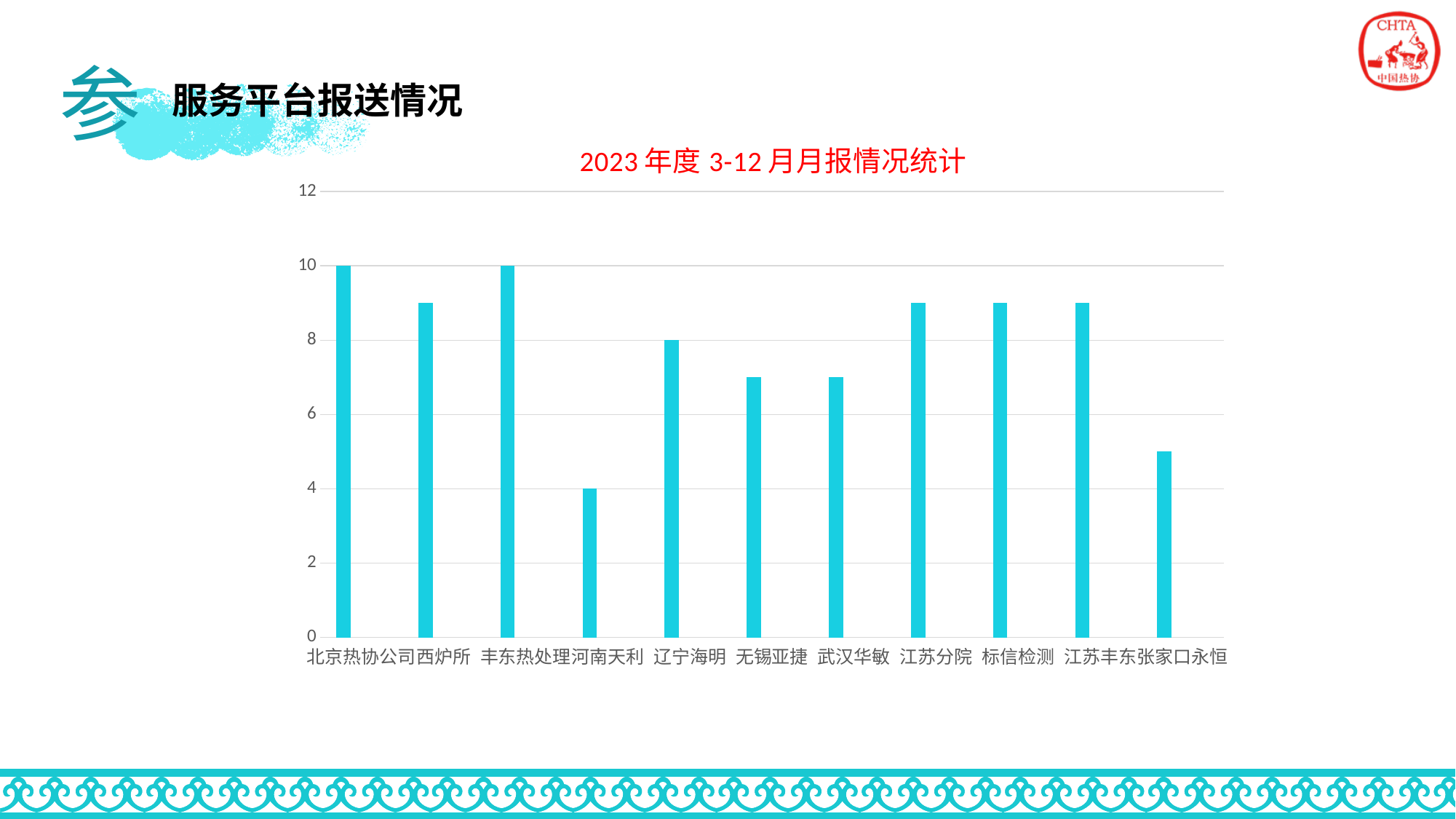
What is the value for 辽宁海明? 8 How many categories are shown on the x axis of the chart? 11 What is the value for 北京热协公司? 10 What is the title of the chart? 2023年度3-12月月报情况统计 What is the value for 丰东热处理? 10 What is the difference between the values for 北京热协公司 and 河南天利? 6 Is the value for 张家口永恒 greater or less than 6? less Which is larger, the value for 辽宁海明 or the value for 河南天利? 辽宁海明 What is the value for 河南天利? 4 Is the value for 西炉所 greater or less than 8? greater What kind of chart is shown on the slide? bar chart Which category has the lowest value? 河南天利